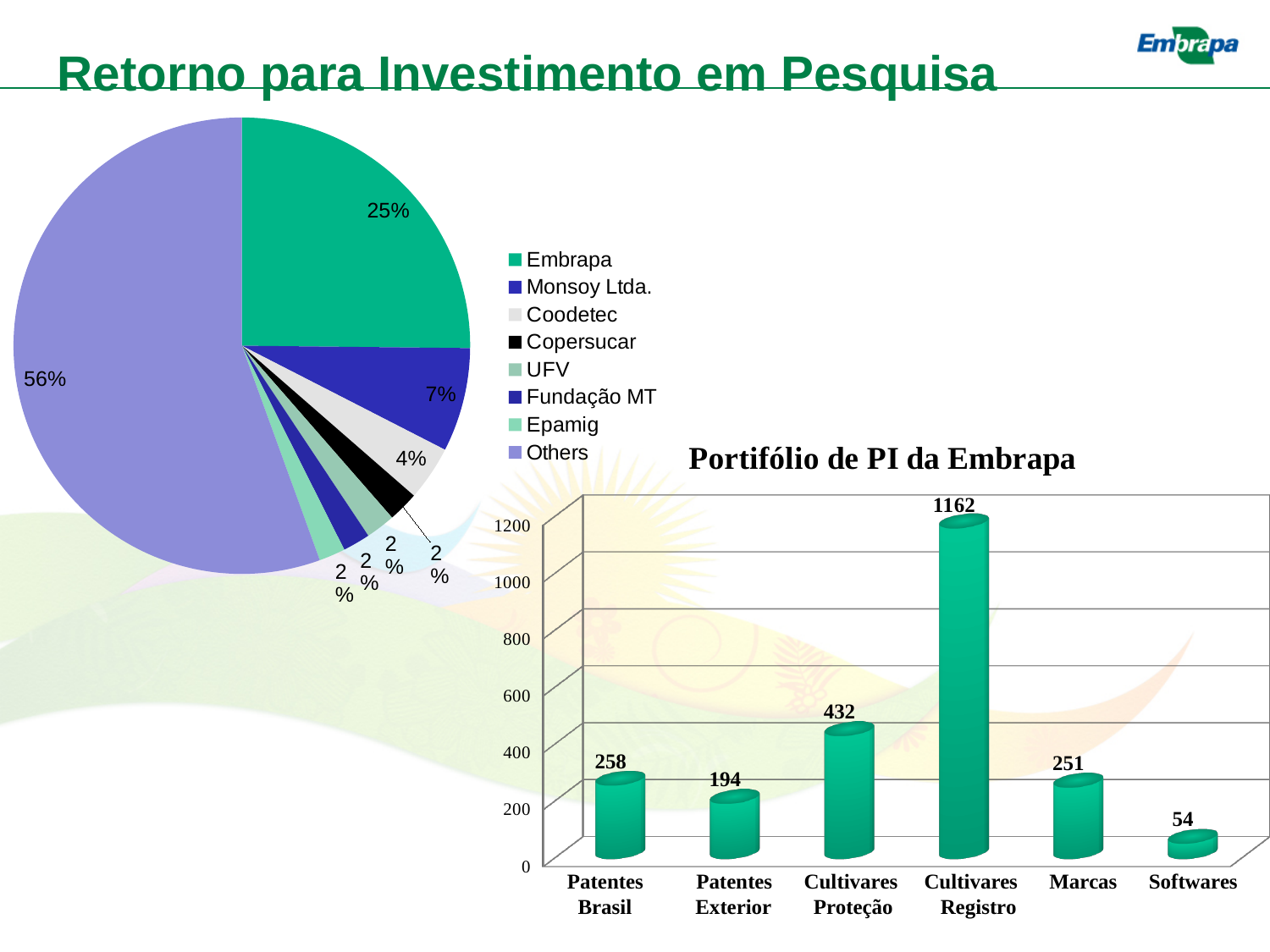
In the pie chart on the left of the slide, what share does Embrapa have? 25% How many entries does the legend of the pie chart on the left of the slide list? 8 In the bar chart titled 'Portifólio de PI da Embrapa', what is the difference between Cultivares Proteção and Patentes Brasil? 174 In the bar chart titled 'Portifólio de PI da Embrapa', which is larger, Patentes Brasil or Marcas? Patentes Brasil In the pie chart on the left of the slide, what share does Others have? 56% What kind of chart is the chart titled 'Portifólio de PI da Embrapa'? Bar chart In the pie chart on the left of the slide, which slice is the largest? Others In the bar chart titled 'Portifólio de PI da Embrapa', what is the value for Patentes Exterior? 194 In the bar chart titled 'Portifólio de PI da Embrapa', which category has the lowest value? Softwares In the bar chart titled 'Portifólio de PI da Embrapa', what is the value for Cultivares Registro? 1162 In the bar chart titled 'Portifólio de PI da Embrapa', which category has the highest value? Cultivares Registro How many categories are shown in the bar chart titled 'Portifólio de PI da Embrapa'? 6